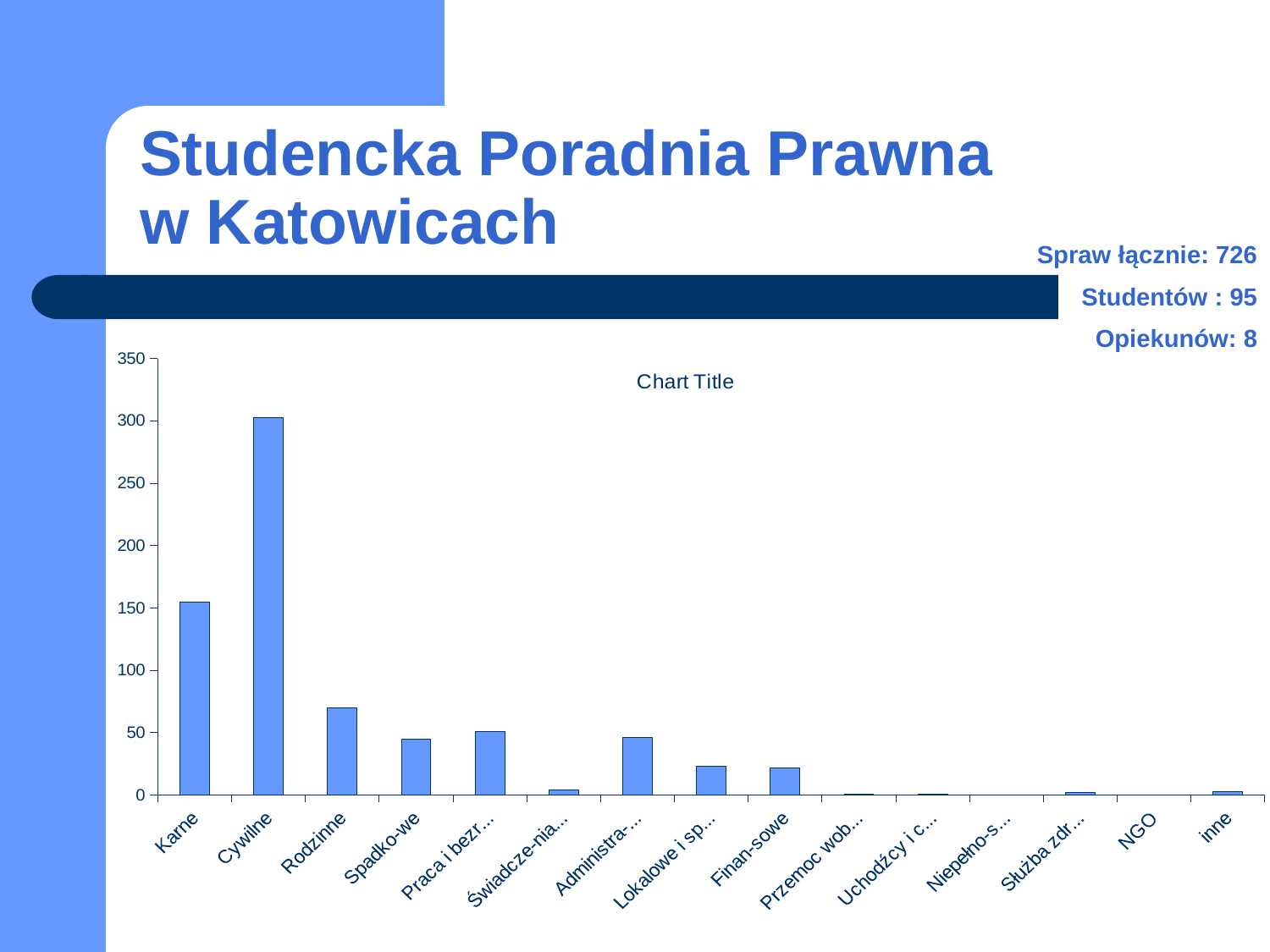
What is the title shown on the chart? Chart Title How many categories are shown on the x axis of the chart? 15 What kind of chart is shown on the slide? bar chart Is the value for Lokalowe i sp... greater or less than 50? less Which category has the highest bar in the chart? Cywilne Which is larger, the value for Cywilne or the value for Karne? Cywilne Is the value for Karne greater or less than 100? greater Is the value for Rodzinne greater or less than 50? greater Which is larger, the value for Karne or the value for Rodzinne? Karne Which is larger, the value for Rodzinne or the value for Spadko-we? Rodzinne